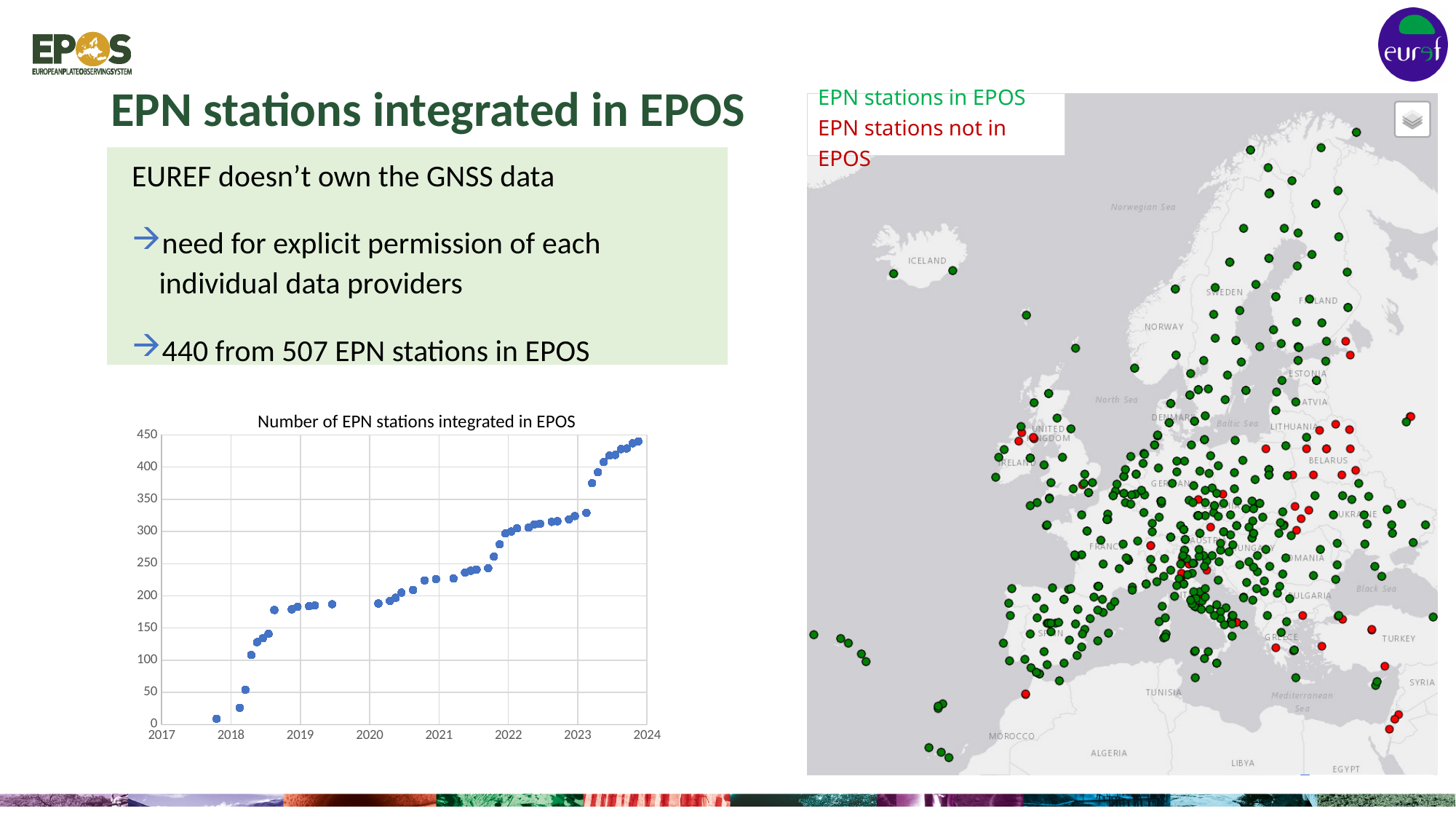
In the chart 'Number of EPN stations integrated in EPOS', in which year do the plotted values first exceed 400? 2023 In the chart 'Number of EPN stations integrated in EPOS', is the value at the start of 2021 greater or less than 250? less How many year labels are shown on the x axis of the chart 'Number of EPN stations integrated in EPOS'? 8 In the chart 'Number of EPN stations integrated in EPOS', which is larger: the value at the start of 2019 or the value at the start of 2023? the value at the start of 2023 In the chart 'Number of EPN stations integrated in EPOS', is the value at the start of 2022 greater or less than 250? greater What is the title of the chart in the lower left of the slide? Number of EPN stations integrated in EPOS In the chart 'Number of EPN stations integrated in EPOS', do the values rise or fall from 2017 to 2024? rise What kind of chart is 'Number of EPN stations integrated in EPOS'? scatter chart What is the highest value shown on the y axis of the chart 'Number of EPN stations integrated in EPOS'? 450